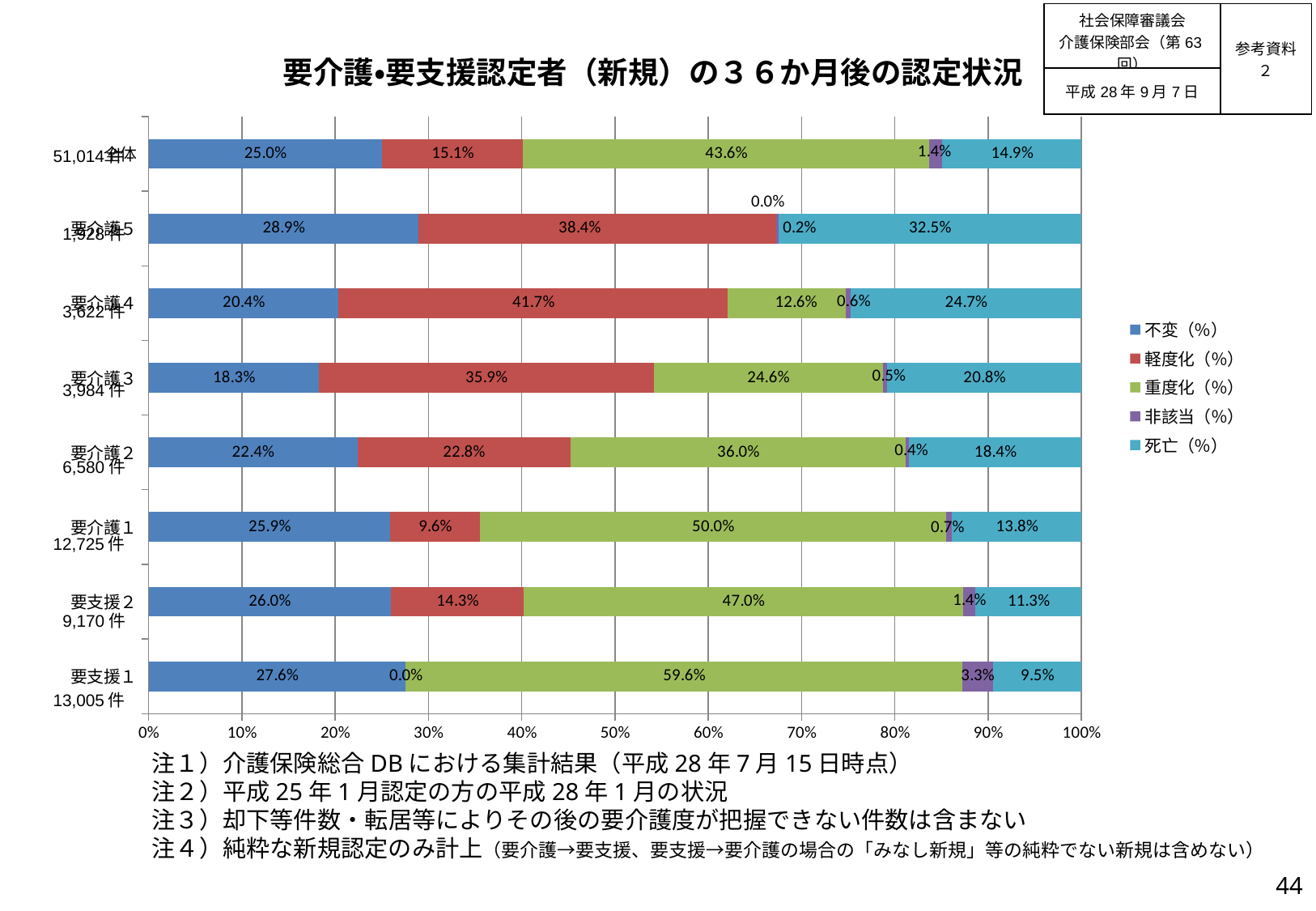
How many series does the legend list? 5 Which category has the highest 重度化（%） value? 要支援１ What is the 重度化（%） value for 要介護１? 50.0% Which category has the highest 死亡（%） value? 要介護５ What kind of chart is shown on the slide? Stacked horizontal bar chart What is the 死亡（%） value for 要介護４? 24.7% Which is larger, the 不変（%） value for 要介護２ or for 要介護３? 要介護２ Which category has the lowest 死亡（%） value? 要支援１ What is the 軽度化（%） value for 要介護５? 38.4% What is the 不変（%） value for 全体? 25.0% What is the difference between the 死亡（%） values for 要介護５ and 要介護１? 18.7 percentage points How many categories are shown on the vertical axis of the chart? 8